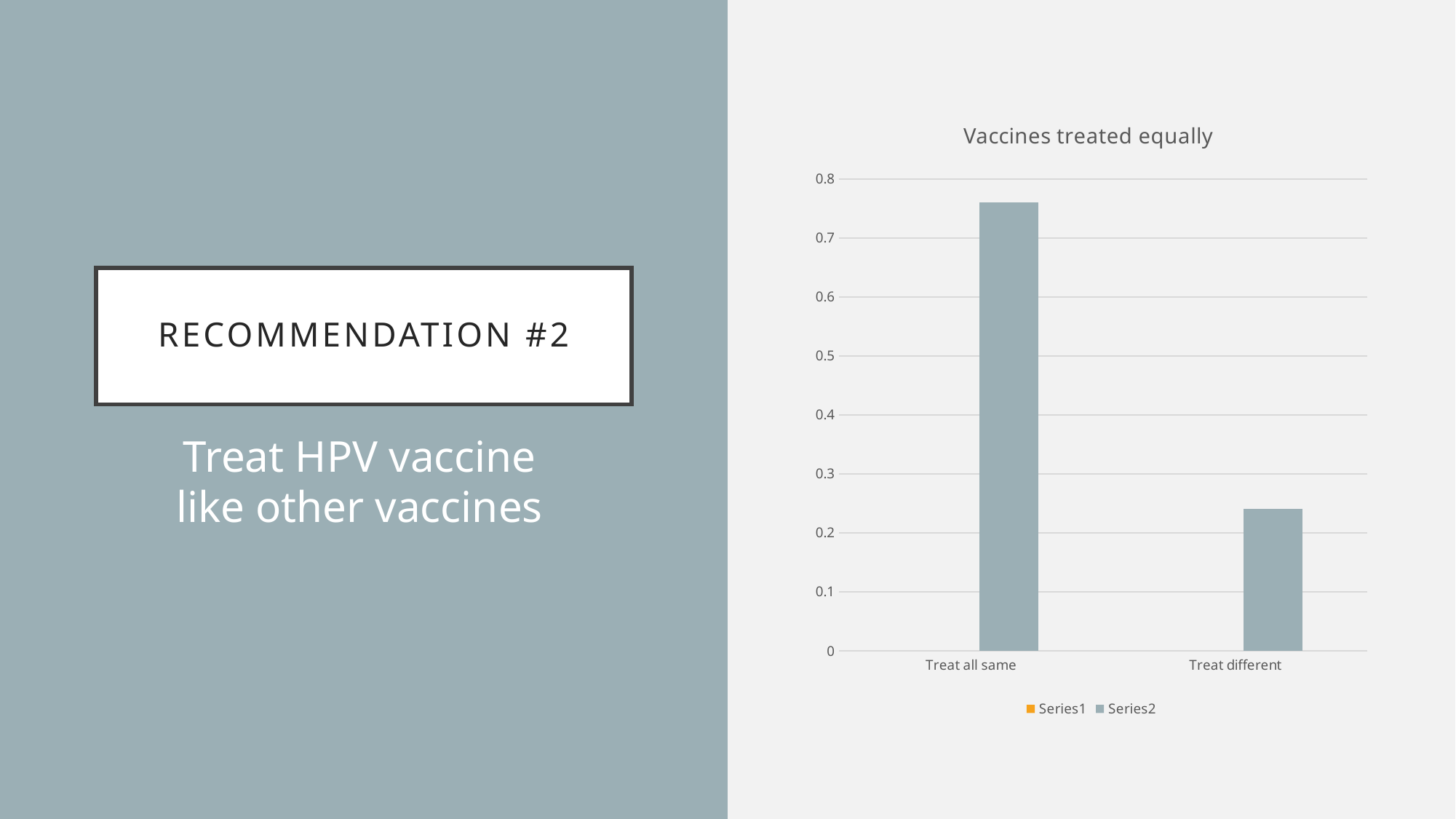
What is the title of the chart? Vaccines treated equally Is the bar for Treat different greater or less than 0.3? less Which is larger, the bar for Treat all same or the bar for Treat different? Treat all same Is the bar for Treat all same greater or less than 0.7? greater Which category has the highest bar in the chart? Treat all same Which category has the lowest bar in the chart? Treat different Is the bar for Treat different greater or less than 0.2? greater What kind of chart is shown on the slide? bar chart Do the bar values rise or fall from Treat all same to Treat different? fall How many categories are shown on the x axis of the chart? 2 What are the names of the series listed in the chart legend? Series1 and Series2 How many series does the chart legend list? 2